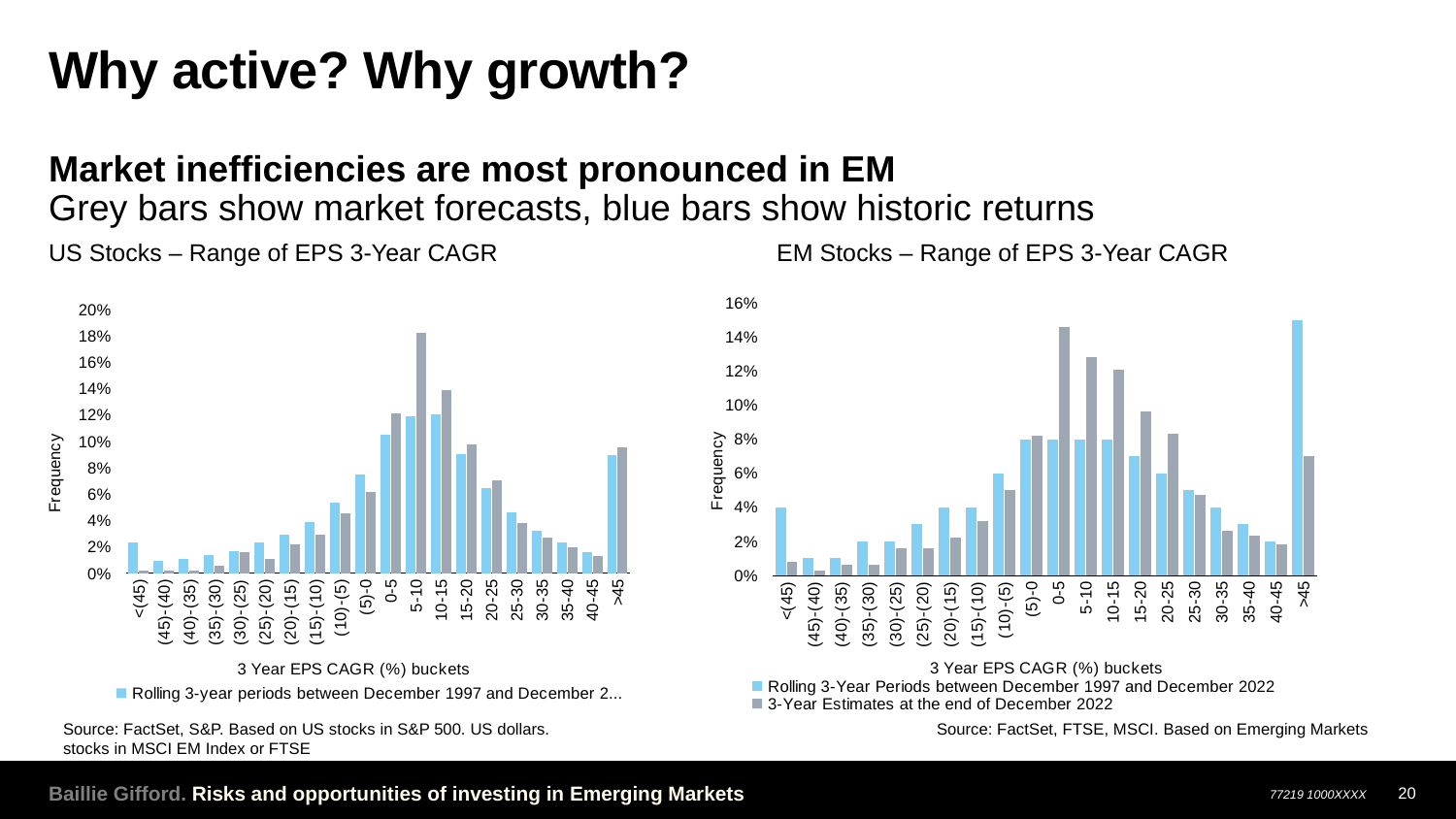
In the 'EM Stocks – Range of EPS 3-Year CAGR' chart, which bucket has the highest grey (3-year estimates) bar? 0-5 What kind of chart is the 'US Stocks – Range of EPS 3-Year CAGR' chart? bar chart In the 'US Stocks – Range of EPS 3-Year CAGR' chart, is the grey bar for the 5-10 bucket greater or less than 16%? greater How many series does the legend of the 'EM Stocks – Range of EPS 3-Year CAGR' chart list? 2 In the 'EM Stocks – Range of EPS 3-Year CAGR' chart, for the >45 bucket, is the blue bar or the grey bar larger? blue bar In the 'EM Stocks – Range of EPS 3-Year CAGR' chart, is the blue bar for the >45 bucket greater or less than 14%? greater In the 'EM Stocks – Range of EPS 3-Year CAGR' chart, which bucket has the highest blue (rolling 3-year periods) bar? >45 How many EPS CAGR buckets are shown on the x axis of the 'EM Stocks – Range of EPS 3-Year CAGR' chart? 20 In the 'EM Stocks – Range of EPS 3-Year CAGR' chart, is the grey bar for the (45)-(40) bucket greater or less than 2%? less What is the y-axis label on the 'EM Stocks – Range of EPS 3-Year CAGR' chart? Frequency In the 'US Stocks – Range of EPS 3-Year CAGR' chart, for the 5-10 bucket, is the blue bar or the grey bar larger? grey bar In the 'US Stocks – Range of EPS 3-Year CAGR' chart, which bucket has the highest grey (estimates) bar? 5-10